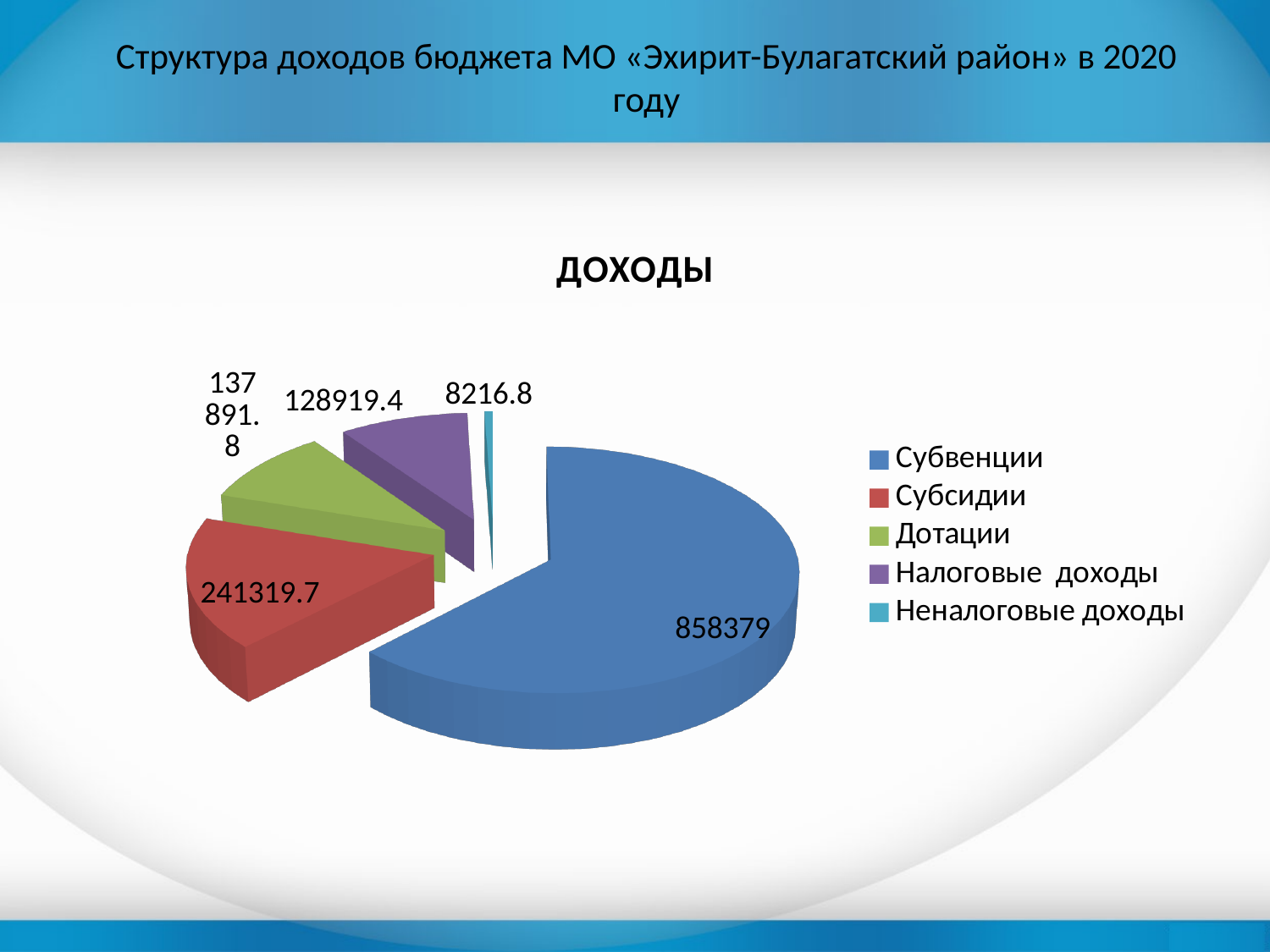
What type of chart is shown on the slide? pie chart What is the value for Дотации? 137891.8 How many entries does the legend list? 5 What is the title of the chart? ДОХОДЫ What is the value for Неналоговые доходы? 8216.8 Which category has the smallest slice? Неналоговые доходы What is the difference between the values for Субвенции and Субсидии? 617059.3 What is the value for Субсидии? 241319.7 How many slices does the pie chart have? 5 What is the value for Субвенции? 858379 What is the value for Налоговые доходы? 128919.4 Which category has the largest slice? Субвенции